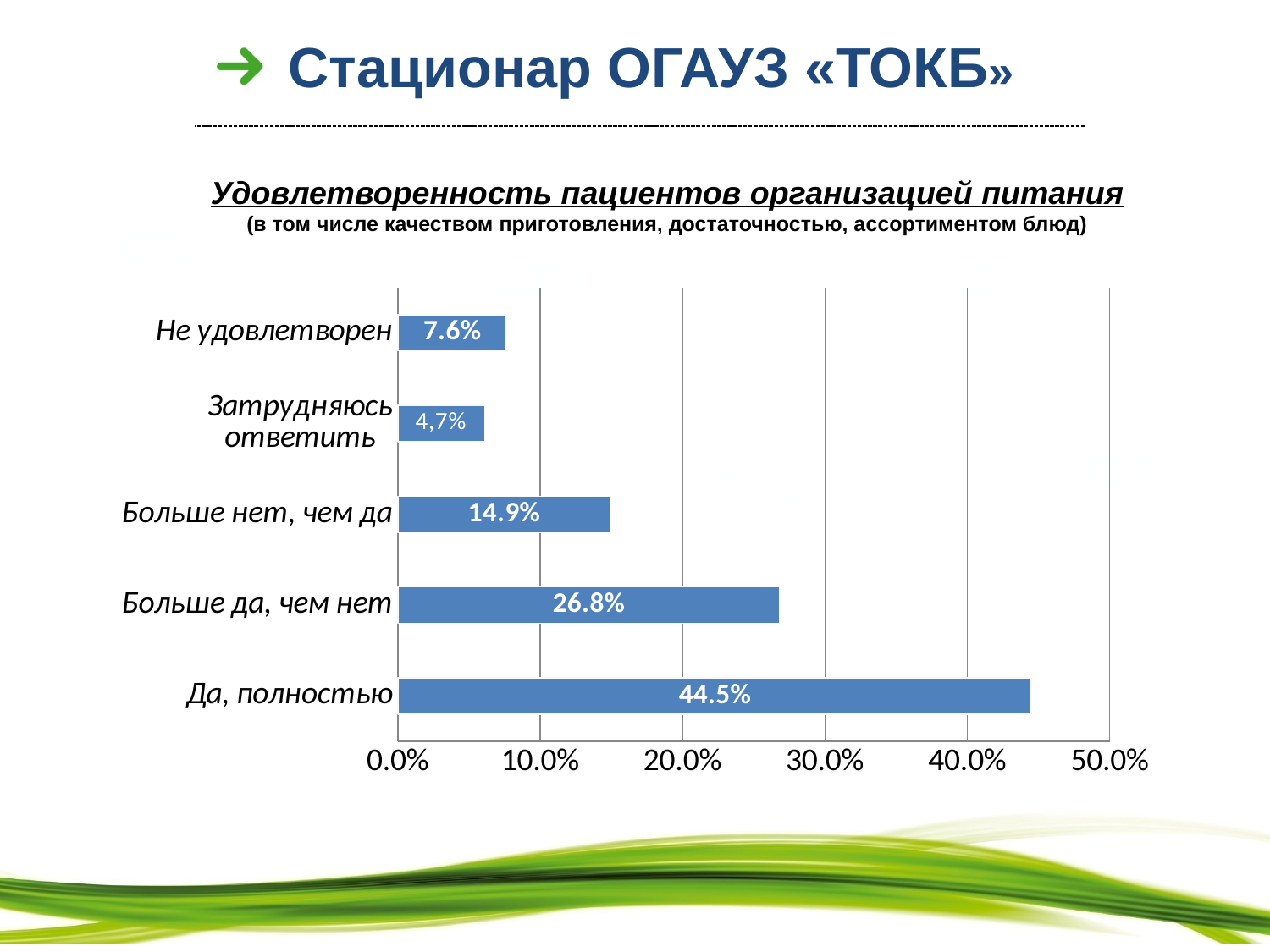
Which is larger: the value for «Больше нет, чем да» or the value for «Не удовлетворен»? Больше нет, чем да Which category has the highest value? Да, полностью What is the value for «Больше нет, чем да»? 14.9% Which category has the lowest value? Затрудняюсь ответить What kind of chart is shown on the slide? bar chart What is the value for «Не удовлетворен»? 7.6% What is the difference between the values for «Да, полностью» and «Больше да, чем нет»? 17.7% What is the value for «Больше да, чем нет»? 26.8% How many categories are shown in the chart? 5 Is the value for «Да, полностью» greater or less than 40.0%? greater What is the value for «Да, полностью»? 44.5%